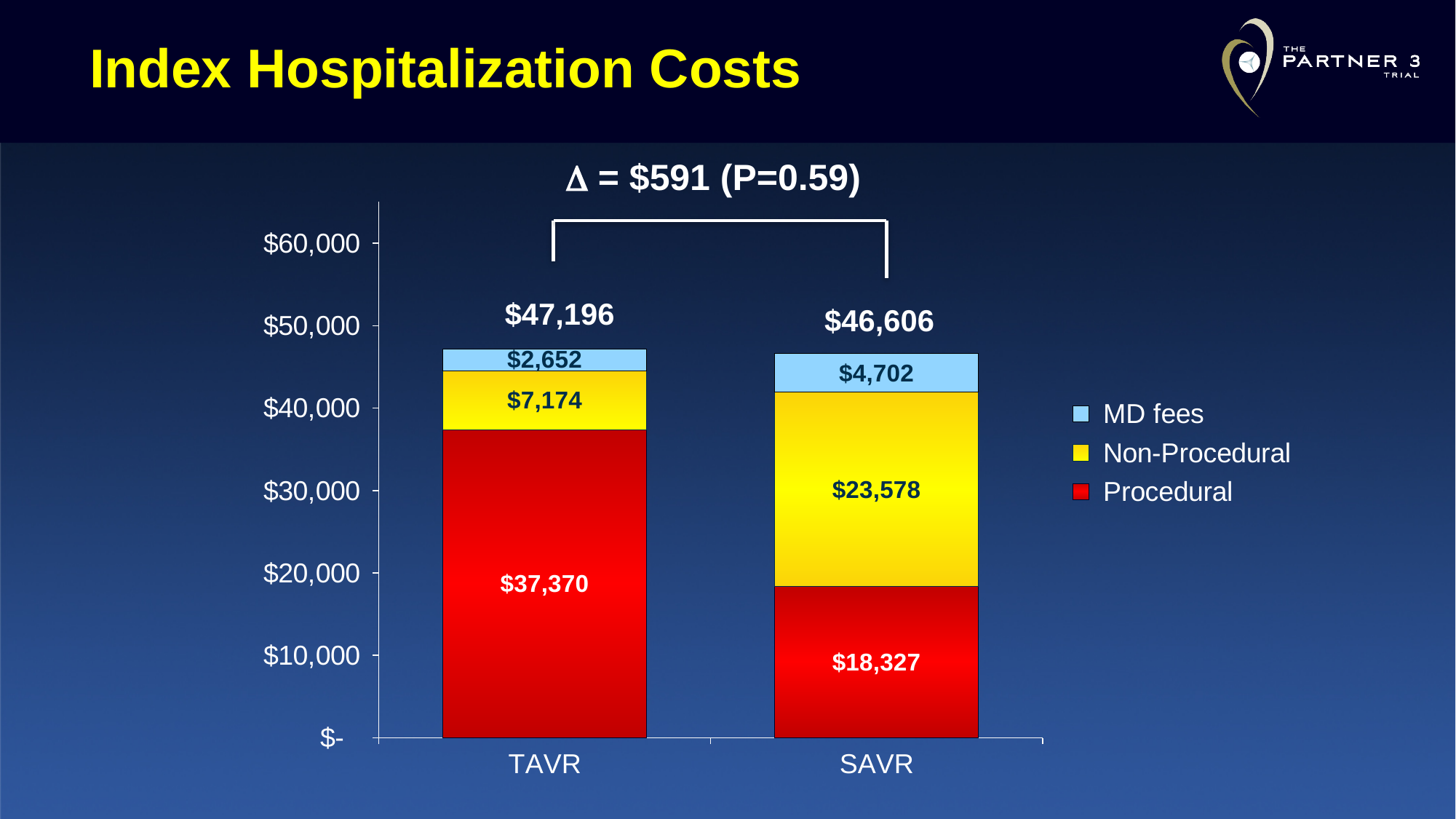
What is the Procedural cost for TAVR? $37,370 What is the total index hospitalization cost for TAVR? $47,196 What is the difference between the Non-Procedural costs of SAVR and TAVR? $16,404 Which group has the higher Procedural cost, TAVR or SAVR? TAVR What is the total index hospitalization cost for SAVR? $46,606 How many series does the legend list? 3 What type of chart is shown on the slide? Stacked bar chart How many categories are shown on the x axis? 2 What is the MD fees value for SAVR? $4,702 What is the Non-Procedural cost for SAVR? $23,578 What is the MD fees value for TAVR? $2,652 What is the difference in total cost between TAVR and SAVR? $591